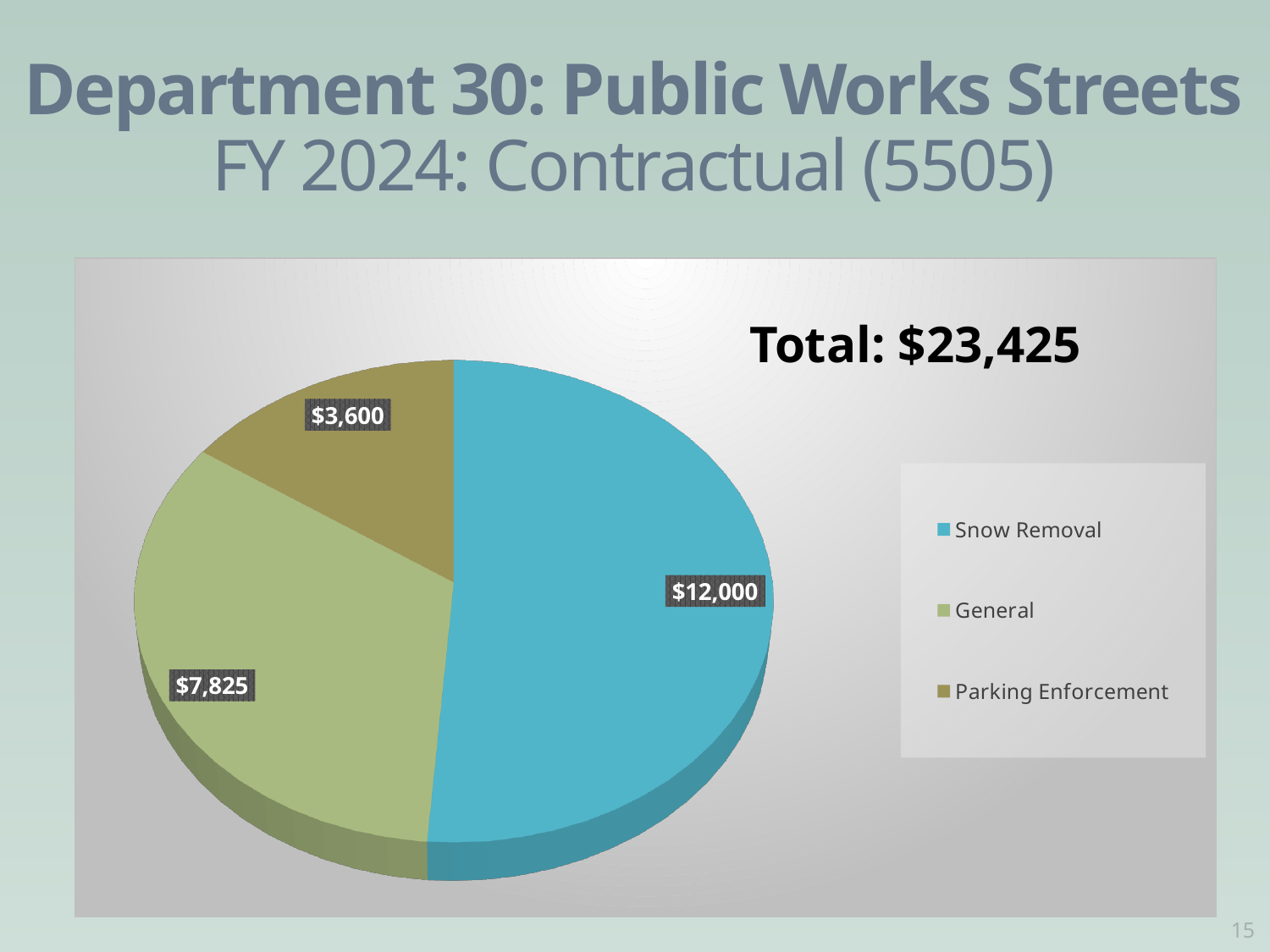
What is the difference between the General and Parking Enforcement values? $4,225 Which category has the smallest slice of the pie? Parking Enforcement Which is larger, the General slice or the Parking Enforcement slice? General What is the value of the Snow Removal slice? $12,000 What colour is the Snow Removal slice? Blue What is the difference between the Snow Removal and General values? $4,175 What is the value of the General slice? $7,825 What total is printed on the chart? $23,425 How many categories are shown in the pie chart? 3 What kind of chart is shown on the slide? Pie chart Which category has the largest slice of the pie? Snow Removal What is the value of the Parking Enforcement slice? $3,600